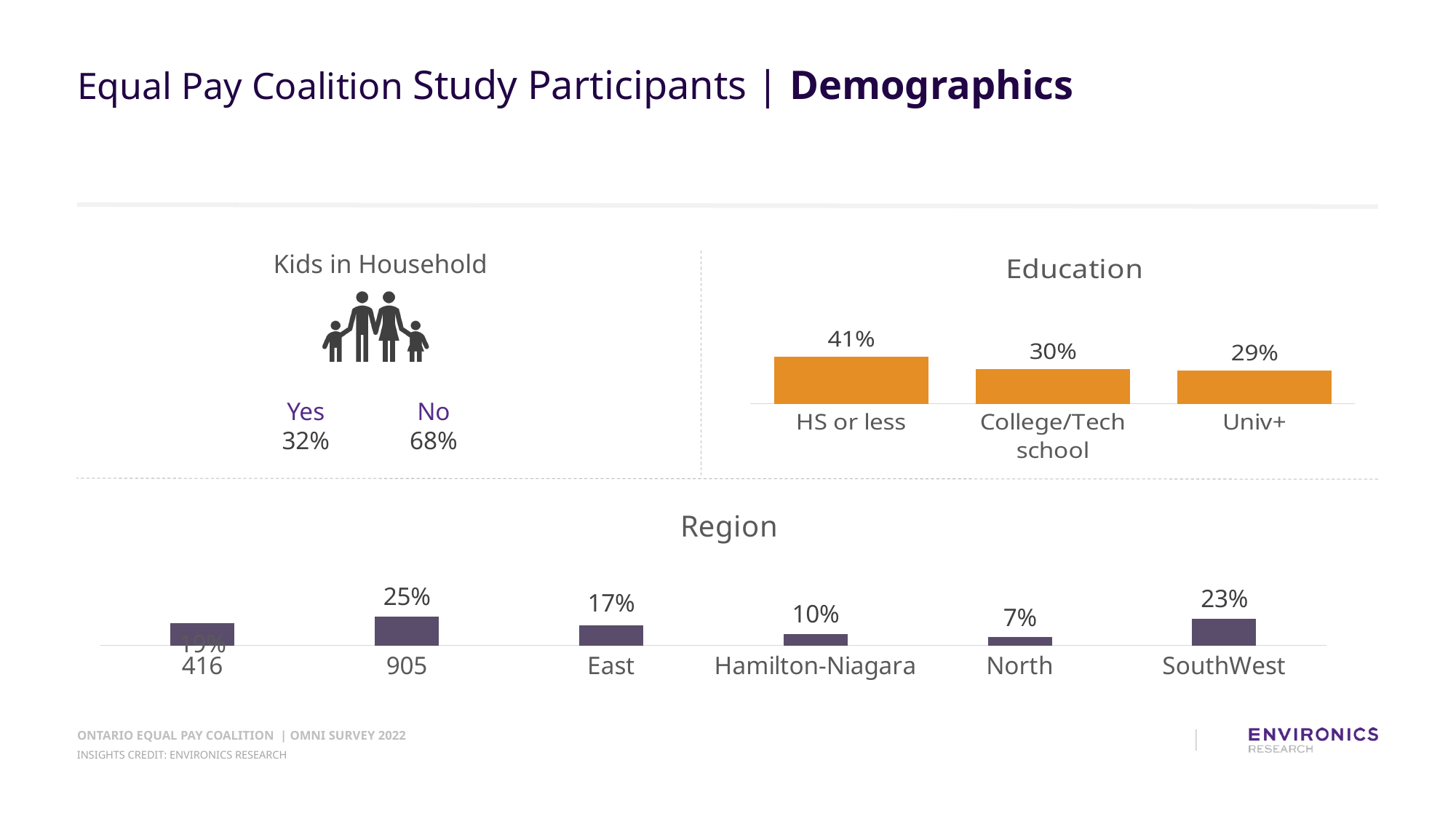
In the Region chart, which region has the highest value? 905 What kind of chart is the Region chart? Bar chart In the Education chart, which category has the highest value? HS or less In the Region chart, what percentage of participants are from the North? 7% In the Region chart, which is larger, East or Hamilton-Niagara? East In the Region chart, what is the value for the 905 region? 25% In the Education chart, what percentage of participants have HS or less? 41% In the Education chart, what is the difference between HS or less and Univ+? 12 percentage points In the Education chart, how many categories are shown? 3 In the Education chart, what is the value for College/Tech school? 30% In the Region chart, which region has the lowest value? North In the Region chart, what is the difference between SouthWest and Hamilton-Niagara? 13 percentage points